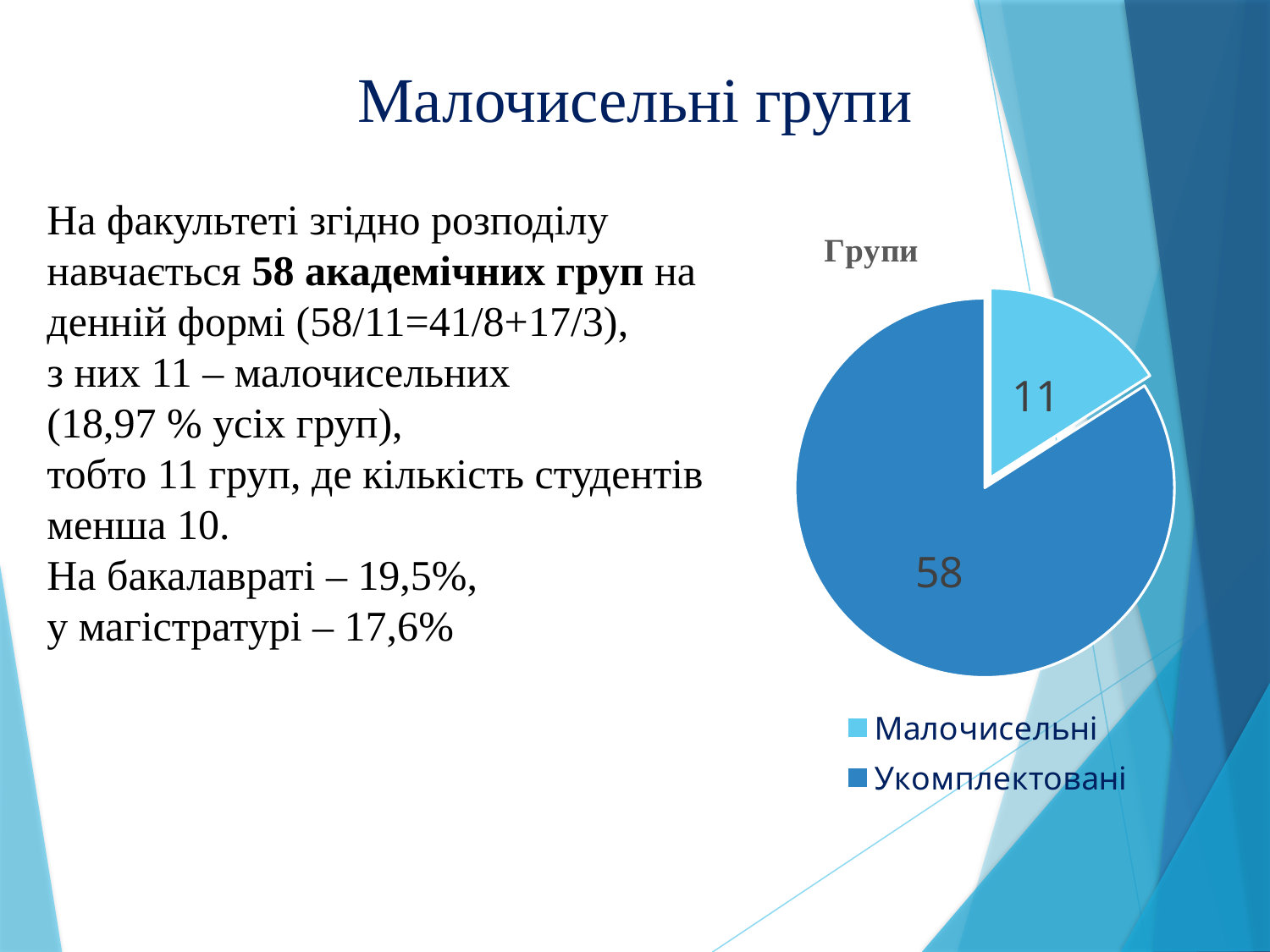
What value is shown for the Укомплектовані slice in the pie chart? 58 What type of chart is shown on the slide? Pie chart What is the difference between the values for Укомплектовані and Малочисельні in the pie chart? 47 How many entries does the legend of the pie chart list? 2 What value is shown for the Малочисельні slice in the pie chart? 11 Which is larger in the pie chart, Малочисельні or Укомплектовані? Укомплектовані Which category has the largest slice in the pie chart? Укомплектовані How many slices does the pie chart have? 2 Which legend entry is shown in the lighter blue colour in the pie chart? Малочисельні What is the title of the chart on the slide? Групи Which category has the smallest slice in the pie chart? Малочисельні